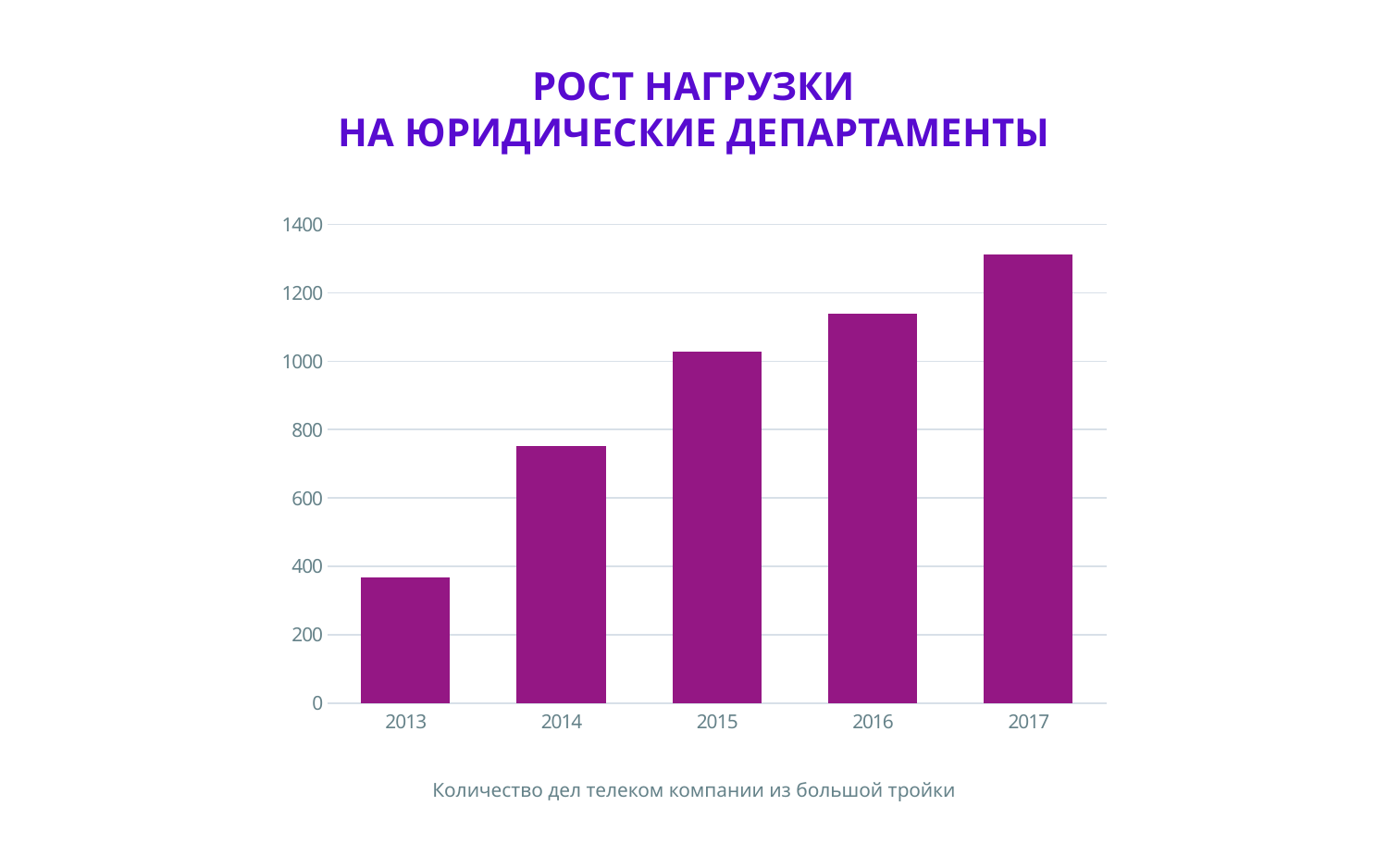
Is the value for 2014 greater or less than 800? less What is the title of the chart on the slide? РОСТ НАГРУЗКИ НА ЮРИДИЧЕСКИЕ ДЕПАРТАМЕНТЫ What is the caption below the chart? Количество дел телеком компании из большой тройки Is the value for 2013 greater or less than 400? less What kind of chart is shown on the slide? bar chart Which is larger, the value for 2014 or the value for 2016? 2016 Is the value for 2016 greater or less than 1200? less How many years are shown on the x axis of the chart? 5 Which year has the highest value in the chart? 2017 Which year has the lowest value in the chart? 2013 Do the values rise or fall from 2013 to 2017? rise